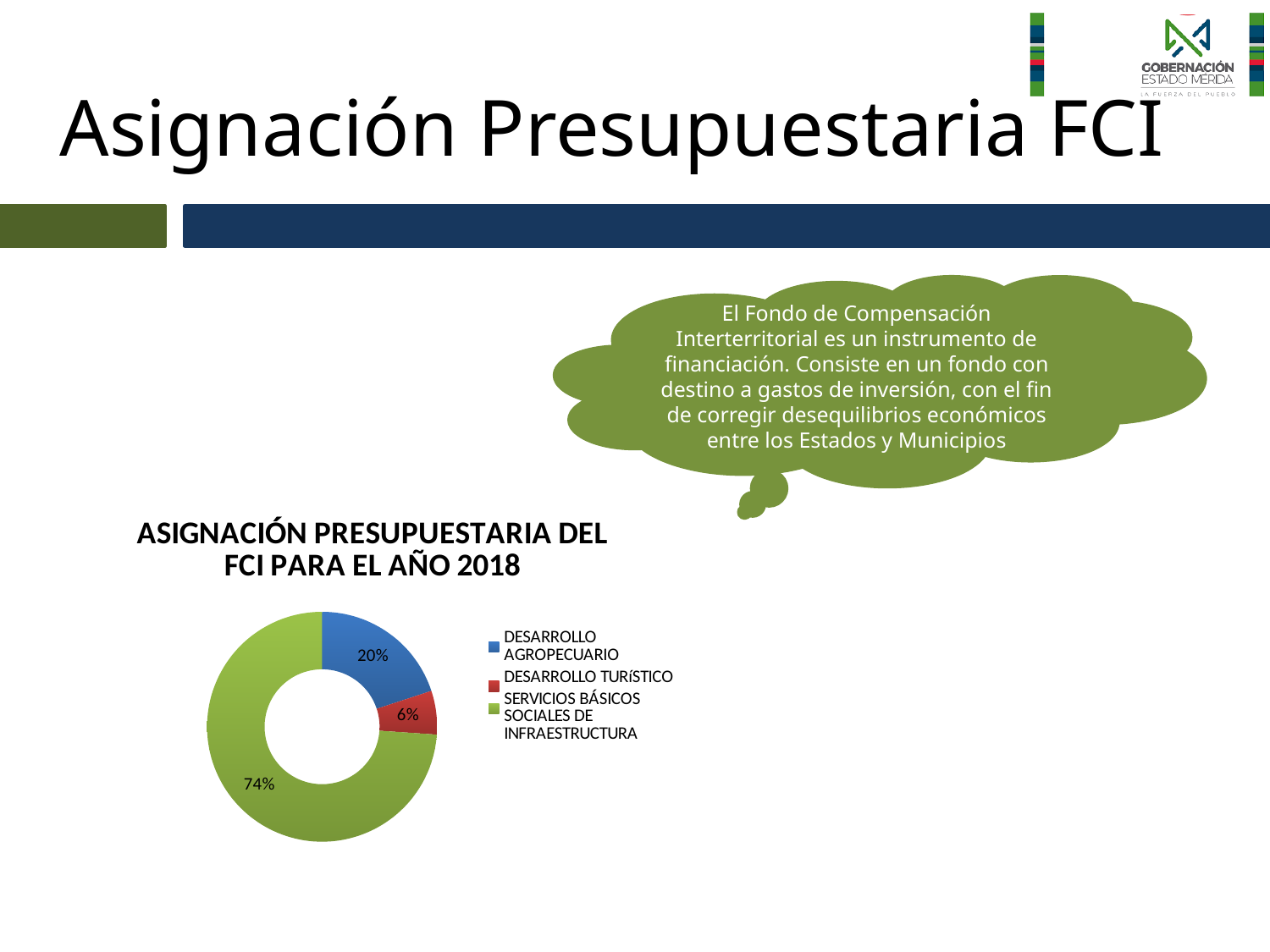
What share of the FCI budget allocation for 2018 goes to DESARROLLO TURíSTICO? 6% How many categories are shown in the chart of the FCI budget allocation for 2018? 3 What is the combined share of DESARROLLO AGROPECUARIO and DESARROLLO TURíSTICO in the 2018 FCI allocation? 26% What share of the FCI budget allocation for 2018 goes to DESARROLLO AGROPECUARIO? 20% What is the title of the chart on the slide? ASIGNACIÓN PRESUPUESTARIA DEL FCI PARA EL AÑO 2018 Which category receives the smallest share of the FCI budget allocation for 2018? DESARROLLO TURíSTICO How many percentage points larger is the share for SERVICIOS BÁSICOS SOCIALES DE INFRAESTRUCTURA than the share for DESARROLLO AGROPECUARIO? 54 percentage points What share of the FCI budget allocation for 2018 goes to SERVICIOS BÁSICOS SOCIALES DE INFRAESTRUCTURA? 74% Which has a larger share of the 2018 FCI allocation, DESARROLLO AGROPECUARIO or DESARROLLO TURíSTICO? DESARROLLO AGROPECUARIO Which category receives the largest share of the FCI budget allocation for 2018? SERVICIOS BÁSICOS SOCIALES DE INFRAESTRUCTURA What kind of chart is used to show the FCI budget allocation for 2018? Pie chart (doughnut) What colour represents DESARROLLO TURíSTICO in the chart? Red